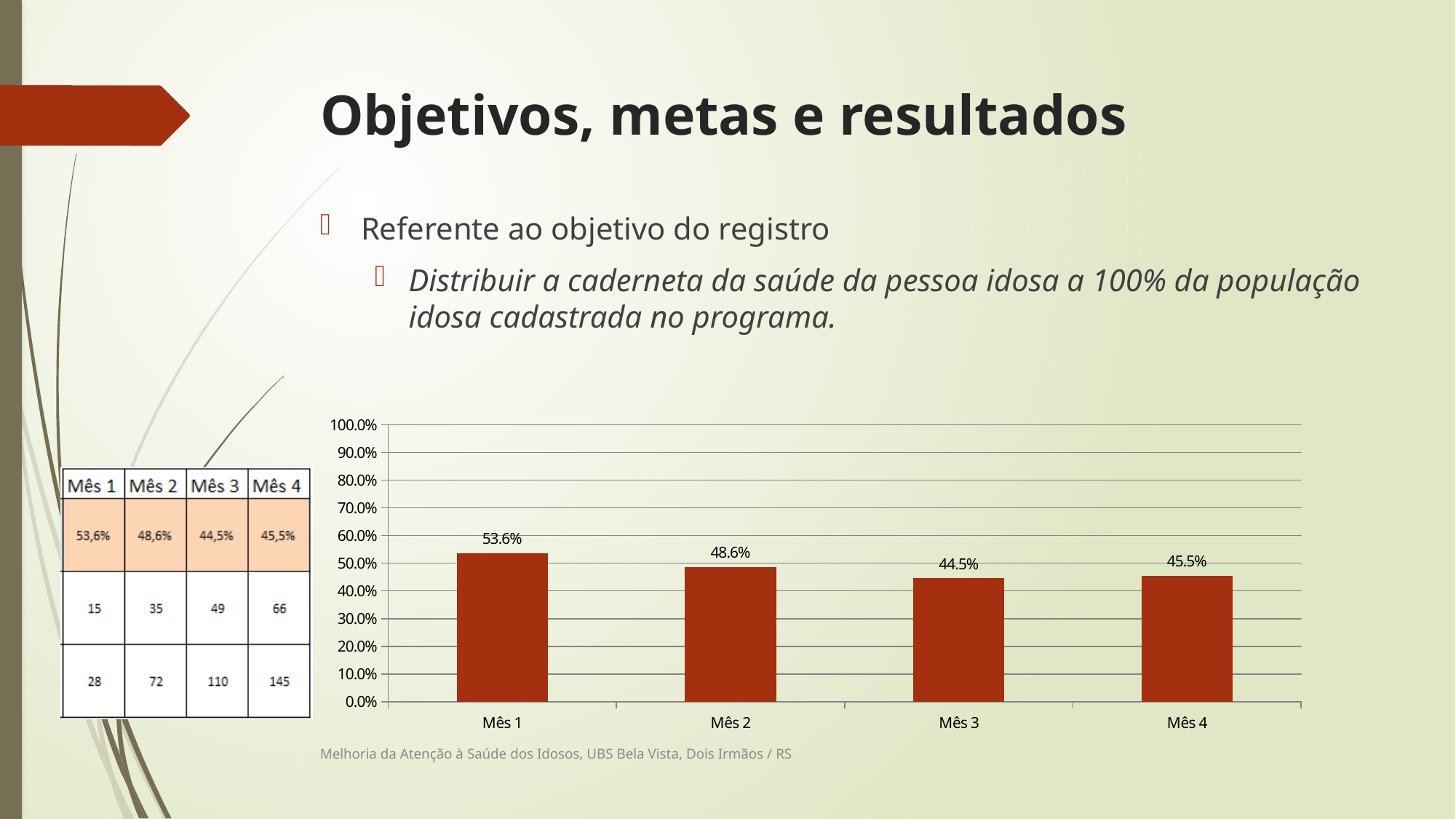
What is the value for Mês 3 in the bar chart? 44.5% Is the value for Mês 1 greater or less than 50.0%? greater What kind of chart is shown on the slide? bar chart What is the value for Mês 2 in the bar chart? 48.6% What is the value for Mês 4 in the bar chart? 45.5% Which month has the lowest value in the bar chart? Mês 3 How many months (categories) are shown in the bar chart? 4 What is the difference between the values for Mês 1 and Mês 2? 5.0% Which month has the highest value in the bar chart? Mês 1 Which is larger, the value for Mês 3 or the value for Mês 4? Mês 4 What is the value for Mês 1 in the bar chart? 53.6% What is the difference between the values for Mês 1 and Mês 3? 9.1%